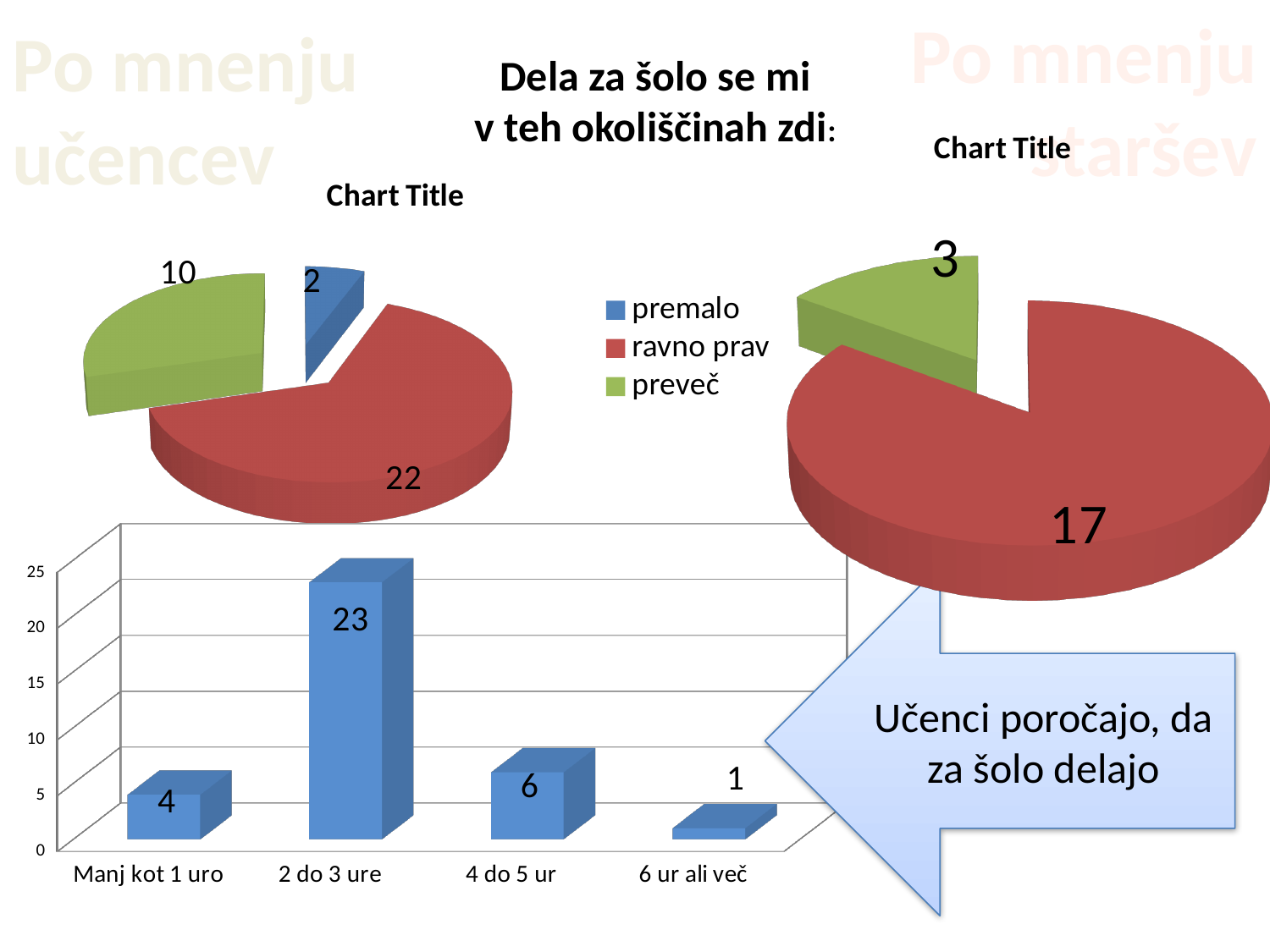
In the bar chart at the bottom of the slide, which category has the highest value? 2 do 3 ure What kind of chart is the chart at the bottom of the slide? bar chart In the pie chart on the right of the slide, what is the value for 'preveč'? 3 In the bar chart at the bottom of the slide, which category has the lowest value? 6 ur ali več How many entries does the legend between the two pie charts list? 3 In the bar chart at the bottom of the slide, what is the difference between the values for '2 do 3 ure' and '4 do 5 ur'? 17 In the bar chart at the bottom of the slide, how many categories are shown on the x axis? 4 In the bar chart at the bottom of the slide, what is the value for 'Manj kot 1 uro'? 4 In the bar chart at the bottom of the slide, what is the value for '2 do 3 ure'? 23 In the pie chart on the left of the slide, what is the value for 'premalo'? 2 In the pie chart on the right of the slide, which slice is larger: 'ravno prav' or 'preveč'? ravno prav In the pie chart on the left of the slide, what is the value for 'ravno prav'? 22